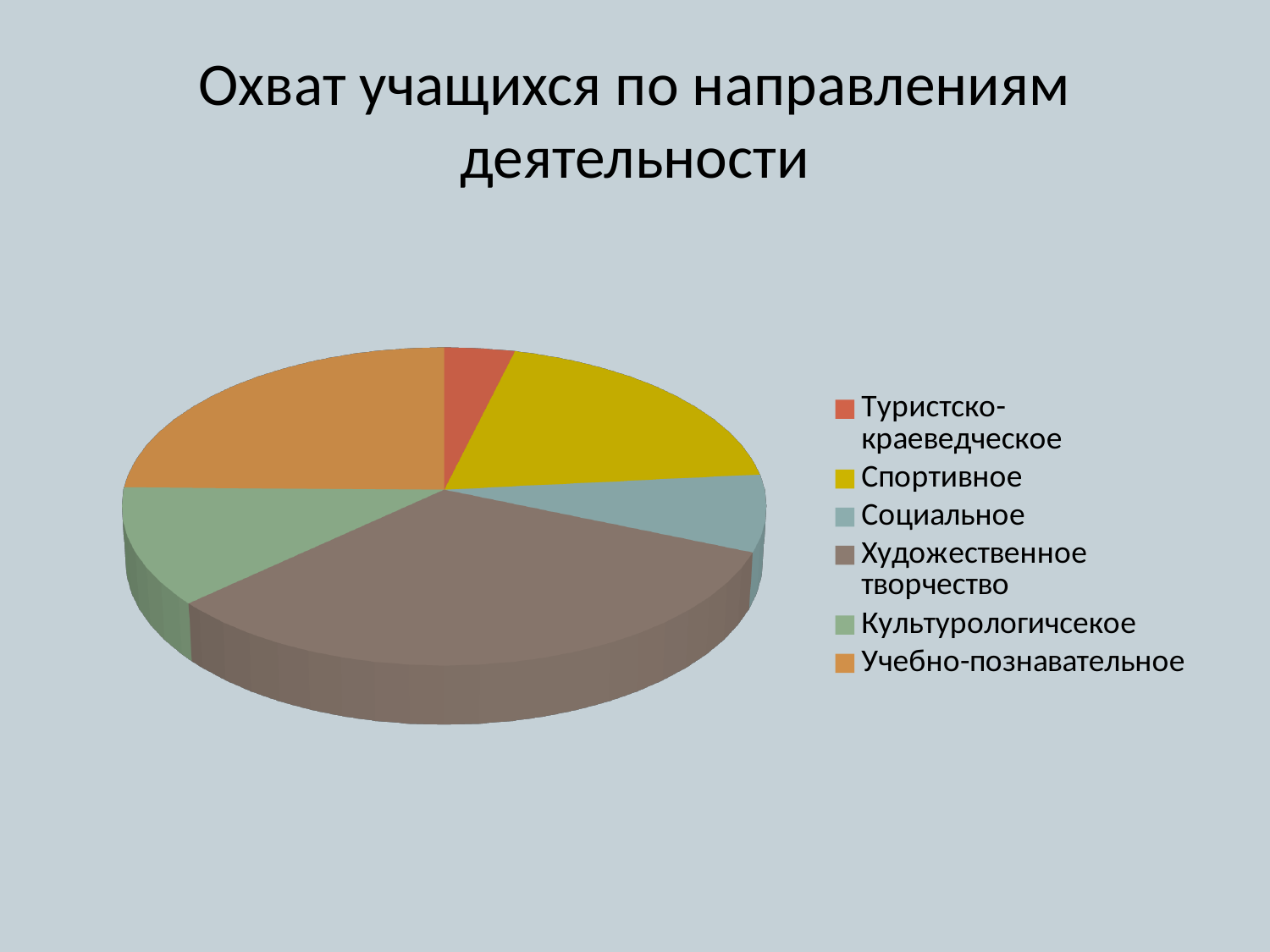
Which category has the smallest slice of the pie? Туристско-краеведческое Which slice is larger: Спортивное or Туристско-краеведческое? Спортивное Which slice is larger: Учебно-познавательное or Социальное? Учебно-познавательное Which category has the largest slice of the pie? Художественное творчество Which slice is larger: Художественное творчество or Культурологичсекое? Художественное творчество Which category is shown in yellow in the legend? Спортивное How many categories does the pie chart show? 6 What is the title of the chart? Охват учащихся по направлениям деятельности What kind of chart is shown on the slide? pie chart